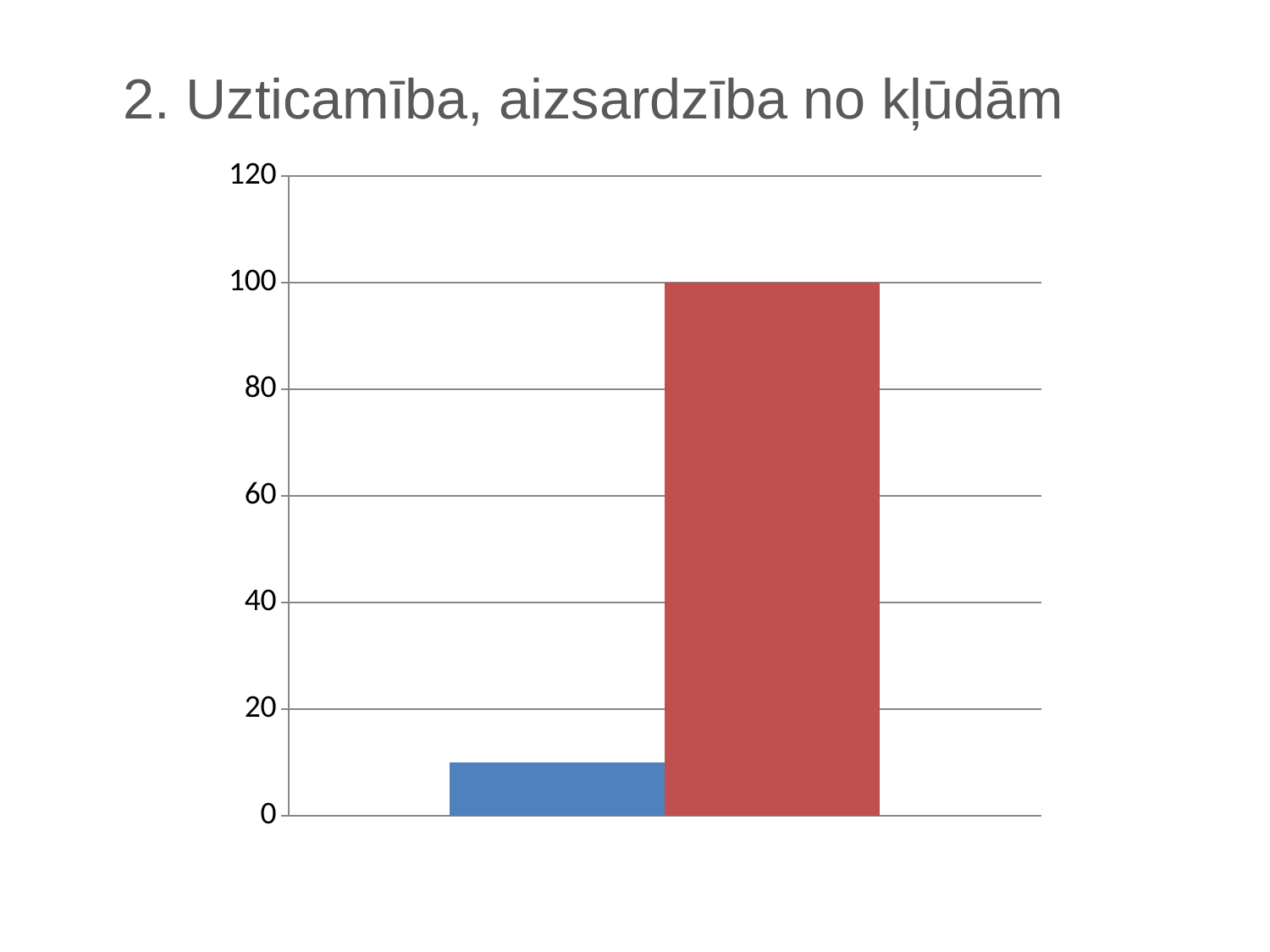
Is the value of the red bar greater or less than 80? greater Which bar has the lowest value? the blue bar Which bar has the highest value? the red bar What is the title of the slide containing the chart? 2. Uzticamība, aizsardzība no kļūdām How many bars are plotted in the chart? 2 Which bar is taller, the blue bar or the red bar? the red bar Is the value of the blue bar greater or less than 20? less What kind of chart is shown on the slide? bar chart What is the highest value shown on the vertical axis? 120 What value does the red bar reach on the vertical axis? 100